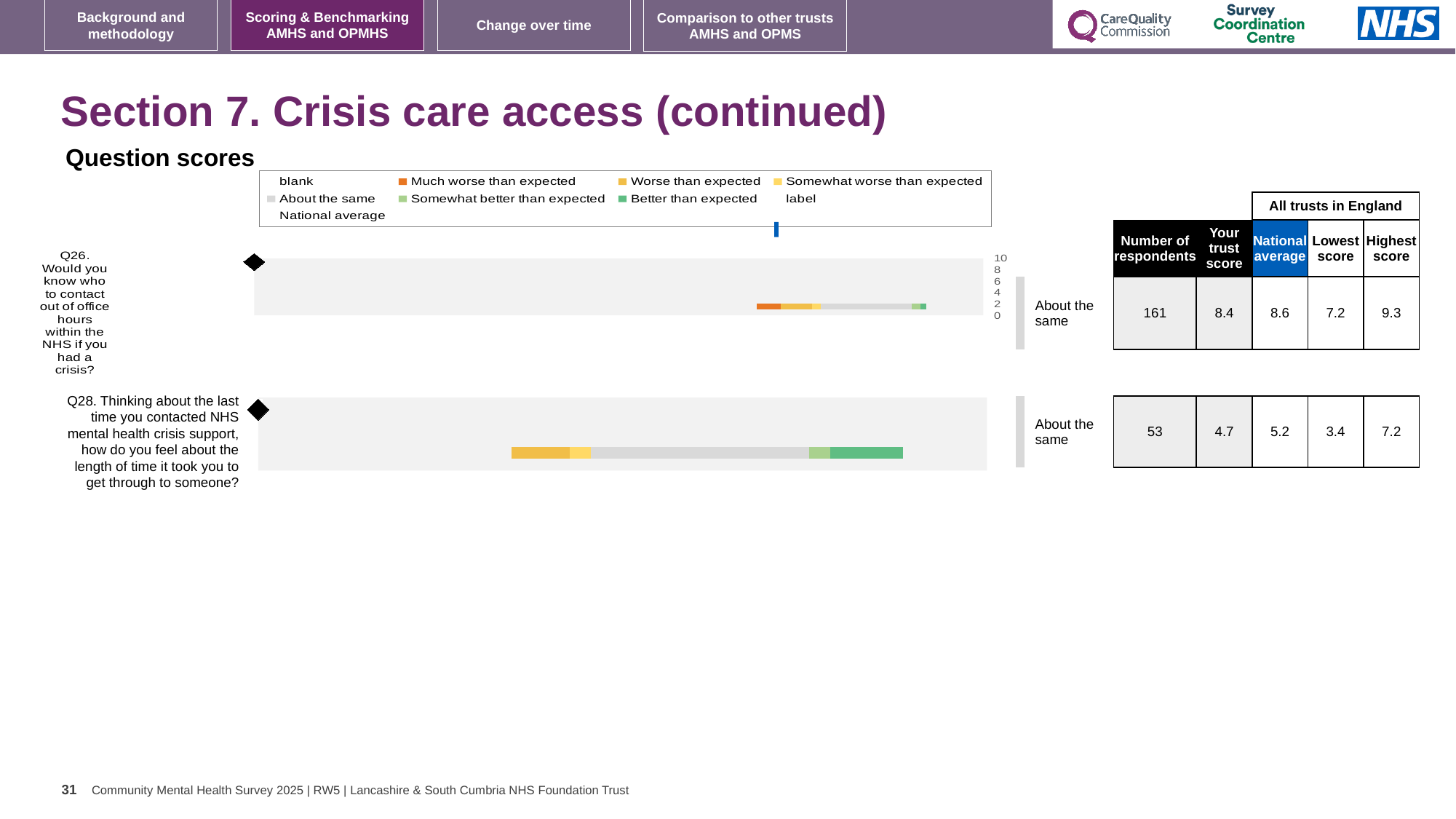
How many entries does the legend of the Question scores chart list? 9 For Q26, which is larger: the trust score or the national average? national average Which benchmark category is shown for Q26 (Would you know who to contact out of office hours within the NHS if you had a crisis?)? About the same What is the difference between the national average (5.2) and the trust score (4.7) for Q28? 0.5 What is the national average for Q28 shown in the table beside the chart? 5.2 What kind of chart is used to show the question scores on this slide? bar chart How many questions are plotted in the Question scores chart? 2 What is the trust score for Q26 shown in the table beside the chart? 8.4 Which of the two questions has the higher trust score? Q26 How many respondents answered Q28 according to the table beside the chart? 53 What colour represents 'Much worse than expected' in the chart legend? orange Which benchmark category is shown for Q28 (how do you feel about the length of time it took you to get through to someone?)? About the same